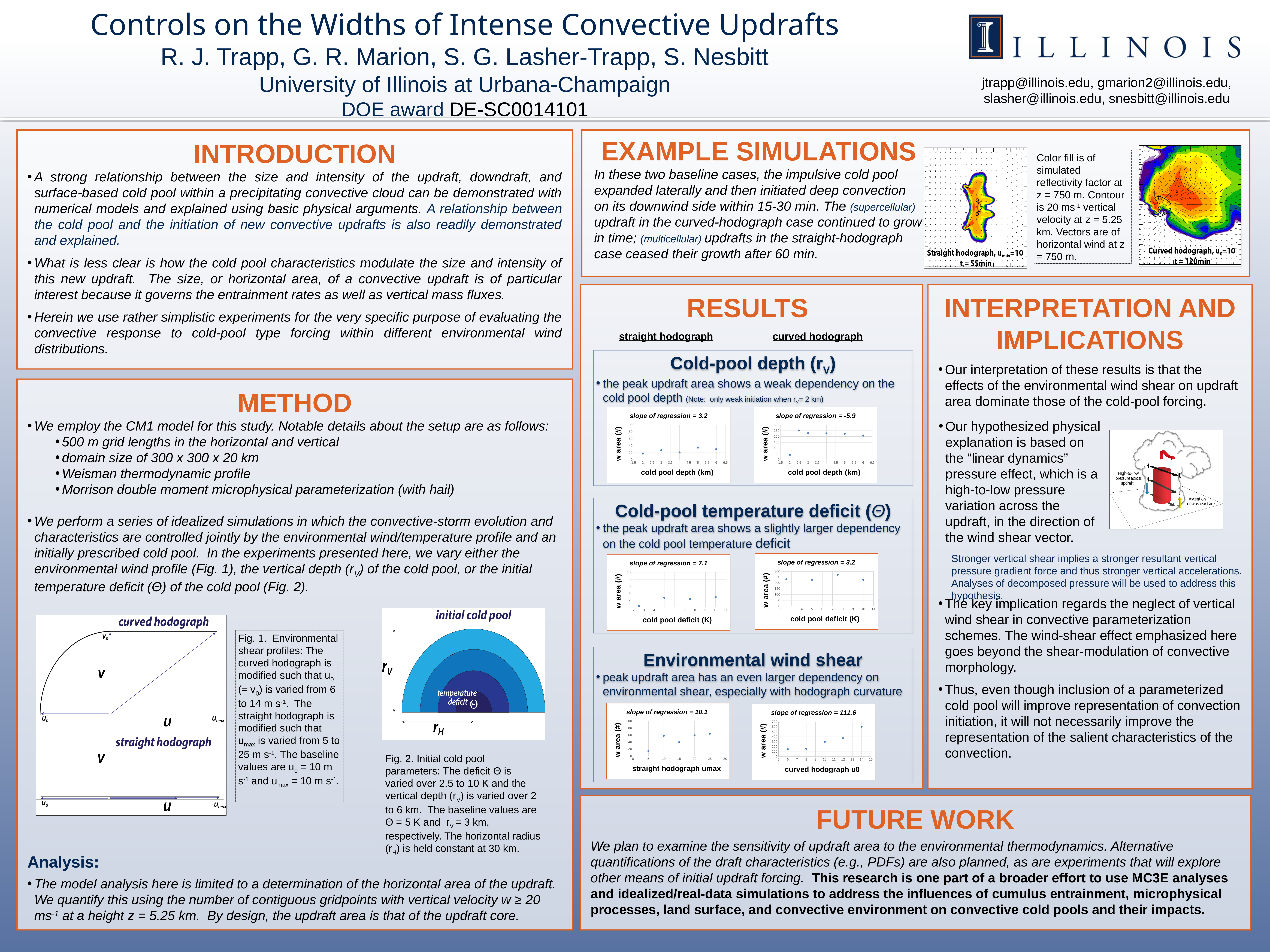
In the Environmental wind shear straight hodograph chart, is the w area value at umax = 5 greater or less than 40? less In the Environmental wind shear curved hodograph chart (x axis 'curved hodograph u0'), do the w area values rise or fall as u0 increases? rise In the Environmental wind shear results, what slope of regression is printed on the curved hodograph chart? 111.6 In the Environmental wind shear curved hodograph chart, which u0 value has the highest w area? 14 In the Environmental wind shear curved hodograph chart, is the w area value at u0 = 6 greater or less than 200? less In the Cold-pool depth curved hodograph chart, is the w area value at a cold pool depth of 2 km greater or less than 200? less In the Results section, what kind of chart is used to show w area against cold pool depth (km) for the straight hodograph? scatter chart In the Cold-pool depth results, what slope of regression is printed on the straight hodograph chart? 3.2 How many data points are plotted in the Cold-pool temperature deficit straight hodograph chart? 4 How many data points are plotted in the Environmental wind shear curved hodograph chart? 5